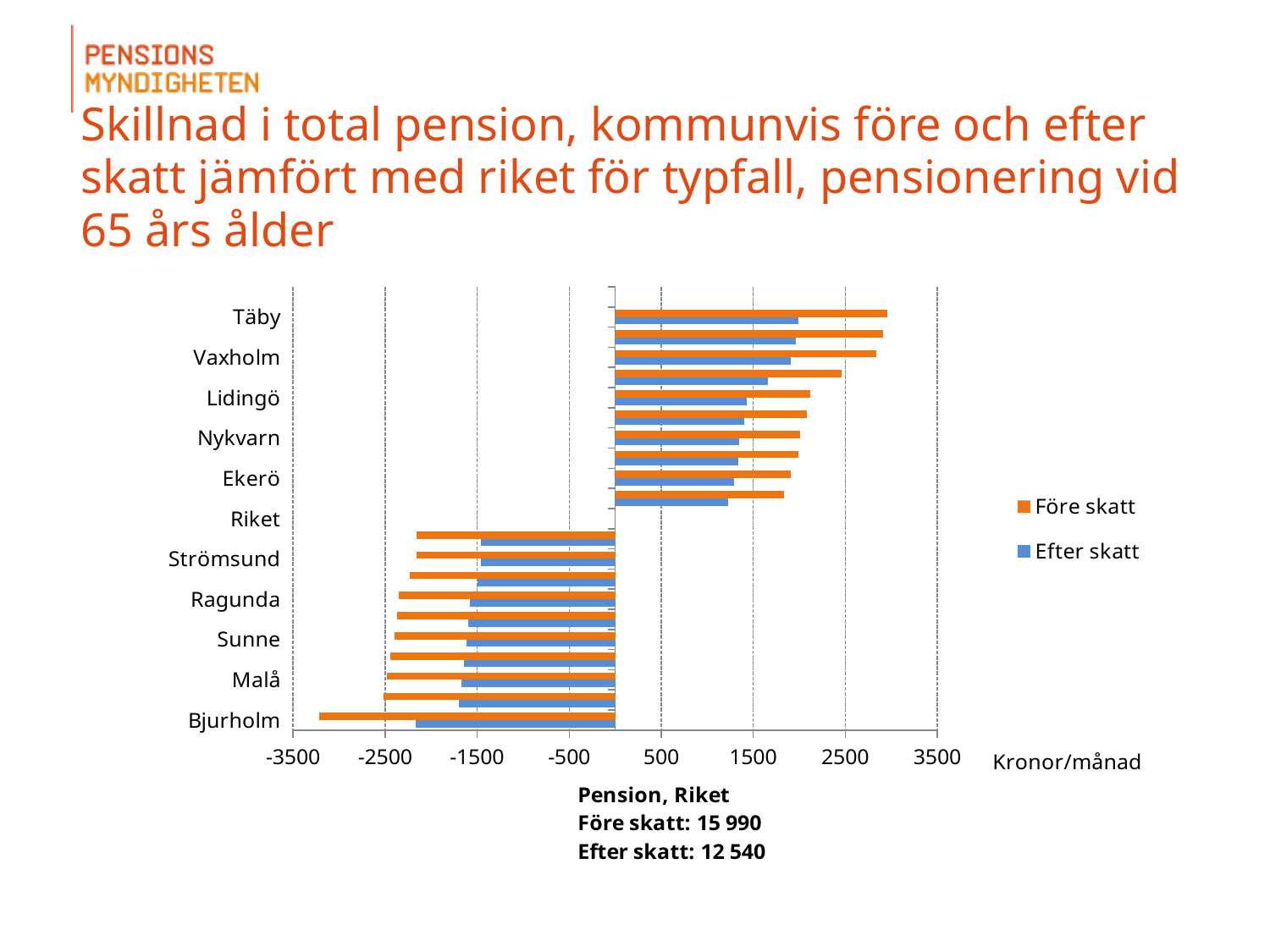
What kind of chart is shown on the slide? bar chart Is the Efter skatt value for Täby greater or less than 1500? greater How many series does the legend list? 2 Is the Före skatt value for Bjurholm greater or less than -2500? less Which municipality has the lowest Före skatt value? Bjurholm Which is larger for Täby, the Före skatt value or the Efter skatt value? Före skatt Which series does the legend list first? Före skatt Which has the larger Före skatt value, Täby or Lidingö? Täby Is the Före skatt value for Täby greater or less than 2500? greater What unit is given on the x axis? Kronor/månad Which municipality has the highest Före skatt value? Täby